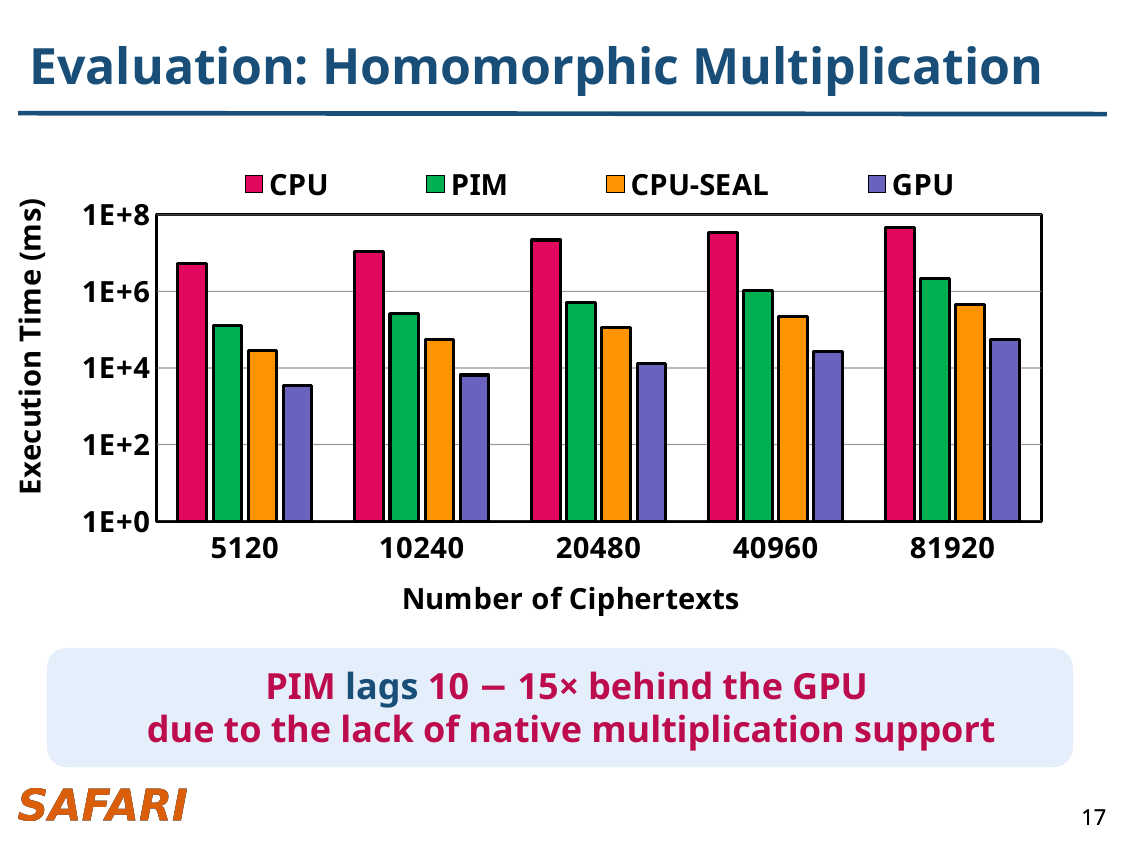
What is the label of the y axis? Execution Time (ms) What colour are the GPU bars? purple How many categories are shown on the x axis? 5 Is the execution time for CPU at 81920 ciphertexts greater or less than 1E+6? greater Is the execution time for GPU at 5120 ciphertexts greater or less than 1E+4? less How many series does the legend list? 4 Which series has the highest execution time at 81920 ciphertexts? CPU Which series has the lowest execution time at 5120 ciphertexts? GPU Which is larger at 20480 ciphertexts, the execution time for PIM or for CPU-SEAL? PIM Is the execution time for CPU-SEAL at 5120 ciphertexts greater or less than 1E+4? greater Does the execution time for CPU rise or fall as the number of ciphertexts increases? rise What kind of chart is shown on the slide? bar chart